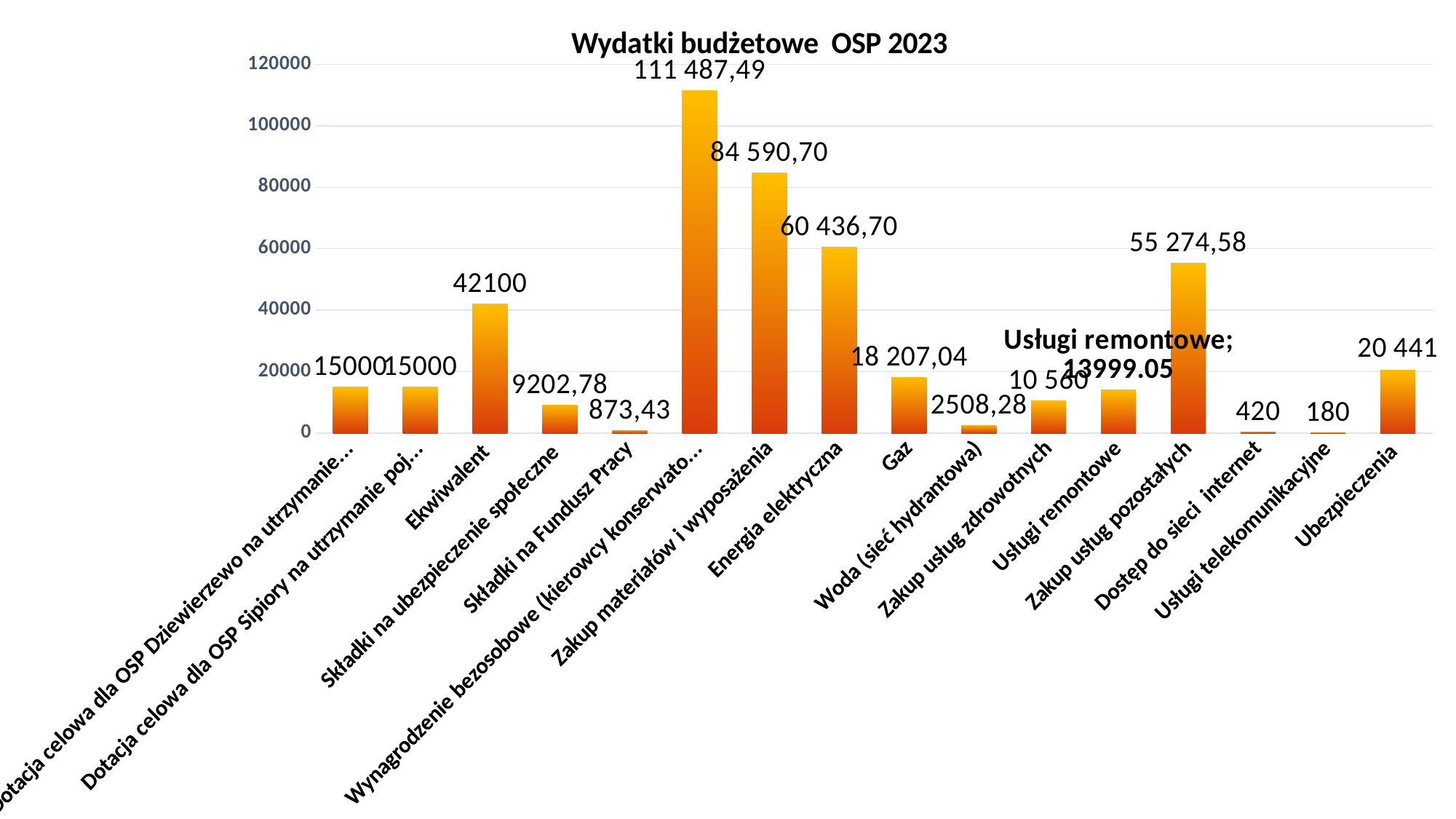
What is the value for Energia elektryczna? 60 436,70 Which is larger, the value for Gaz or the value for Zakup usług zdrowotnych? Gaz What is the value for Ekwiwalent? 42100 Which category has the highest value? Wynagrodzenie bezosobowe (kierowcy konserwato...) What is the title of the chart? Wydatki budżetowe OSP 2023 Is the value for Zakup usług pozostałych greater or less than 60000? less What type of chart is shown on the slide? bar chart What is the value for Zakup usług pozostałych? 55 274,58 Which category has the lowest value? Usługi telekomunikacyjne How many categories are plotted in the chart? 16 What is the difference between the values for Ekwiwalent and Ubezpieczenia? 21659 What is the value for Usługi telekomunikacyjne? 180